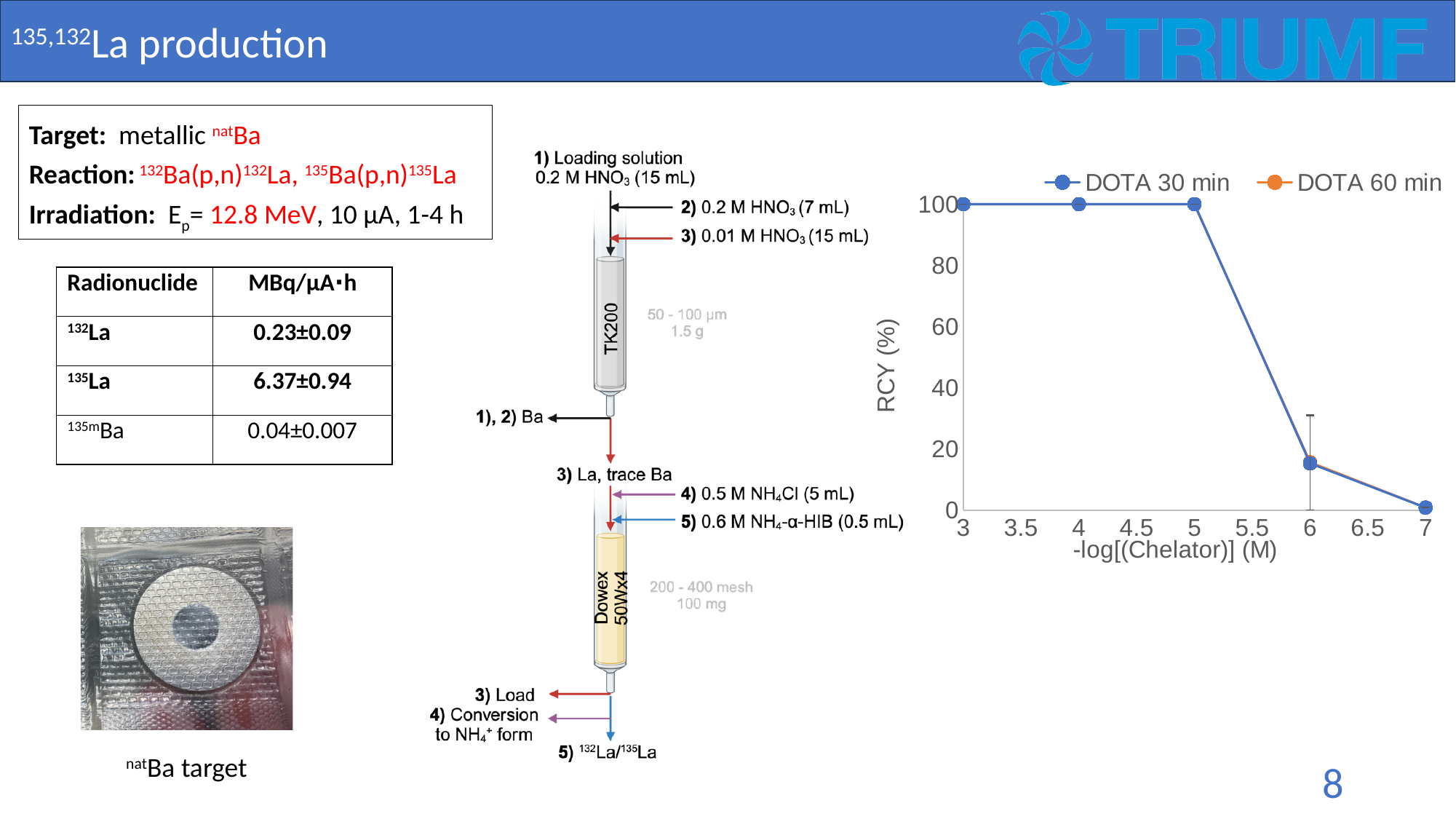
How many data points are plotted for the DOTA 30 min series? 5 Which x-axis value has the lowest RCY for the DOTA 30 min series? 7 What is the label of the y axis of the RCY chart? RCY (%) What are the two series named in the legend of the RCY chart? DOTA 30 min and DOTA 60 min Does the RCY for DOTA 30 min rise or fall as -log[(Chelator)] increases from 5 to 7? fall What is the highest value shown on the y axis of the RCY chart? 100 How many series does the legend of the RCY chart list? 2 Which is larger for DOTA 30 min: the RCY at -log[(Chelator)] = 4 or at -log[(Chelator)] = 6? -log[(Chelator)] = 4 What kind of chart is shown on the right of the slide? line chart Is the RCY value for DOTA 30 min at -log[(Chelator)] = 6 greater or less than 40? less Is the RCY value for DOTA 30 min at -log[(Chelator)] = 5 greater or less than 80? greater Is the RCY value for DOTA 60 min at -log[(Chelator)] = 7 greater or less than 20? less